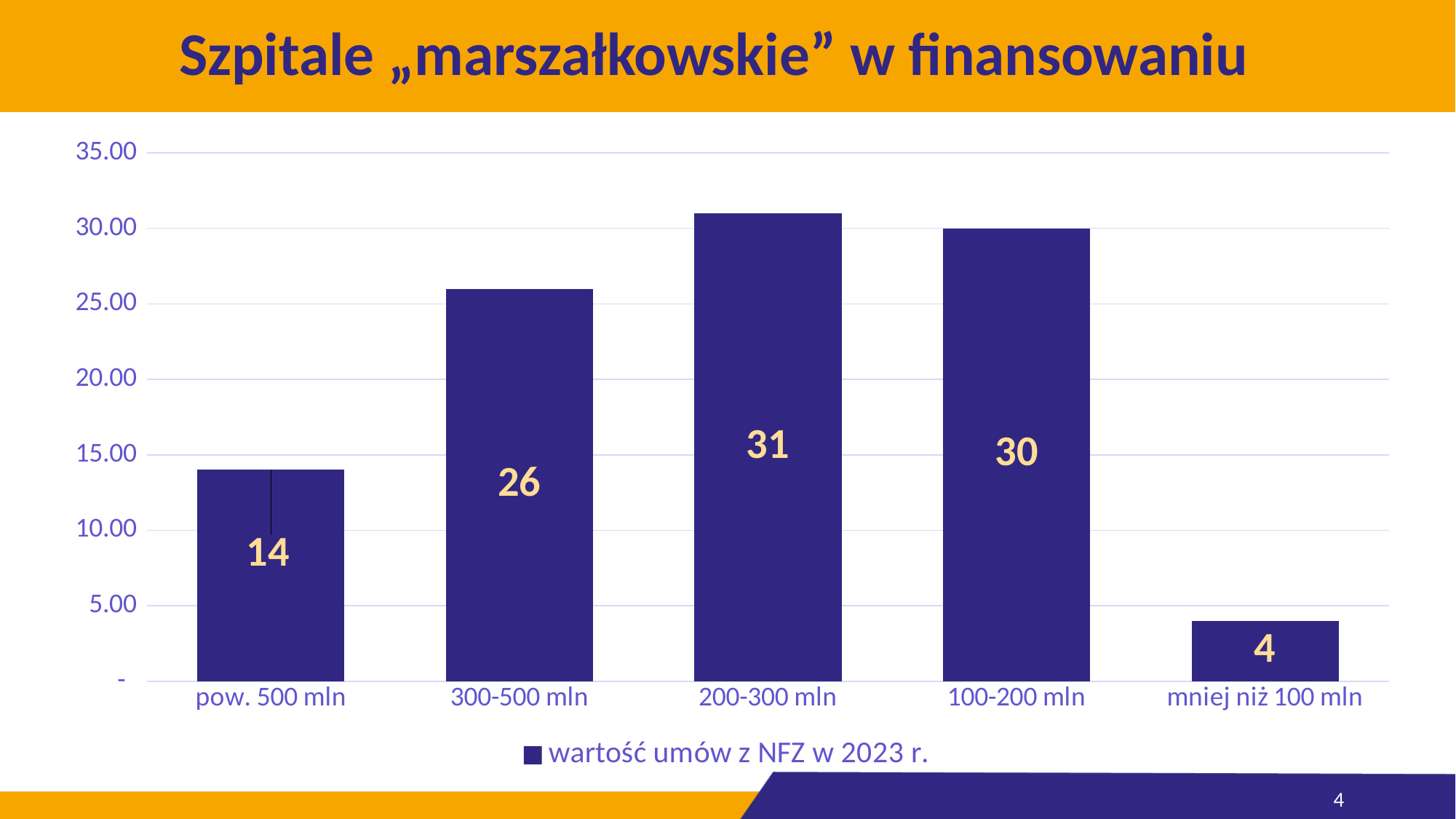
What is the value for the "mniej niż 100 mln" category? 4 Which is larger, the value for "100-200 mln" or the value for "300-500 mln"? 100-200 mln Which category has the highest value? 200-300 mln How many series does the legend list? 1 What is the value for the "pow. 500 mln" category? 14 What is the value for the "200-300 mln" category? 31 Is the value for "300-500 mln" greater or less than 20.00? greater What is the difference between the values for "300-500 mln" and "pow. 500 mln"? 12 How many categories are shown on the x axis? 5 Which category has the lowest value? mniej niż 100 mln What is the legend entry for the series shown? wartość umów z NFZ w 2023 r. What kind of chart is shown on the slide? bar chart